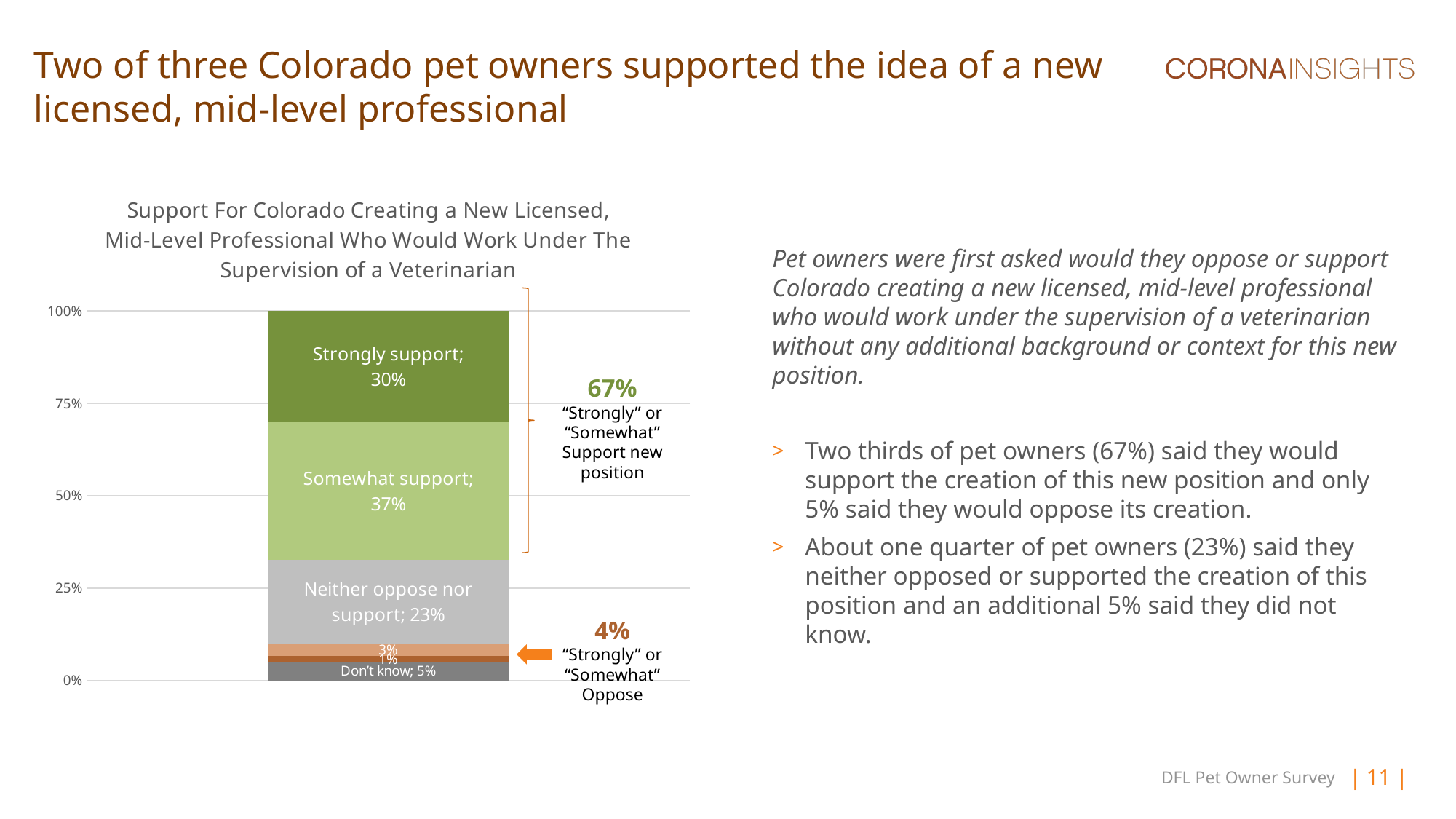
How many segments does the stacked bar contain? 6 What combined percentage of pet owners said they "Strongly" or "Somewhat" support the new position? 67% What percentage of pet owners answered "Don't know"? 5% What is the title of the chart? Support For Colorado Creating a New Licensed, Mid-Level Professional Who Would Work Under The Supervision of a Veterinarian What type of chart is shown on the slide? Stacked bar chart What percentage of pet owners said they somewhat support the new position? 37% Which is larger, the "Strongly support" share or the "Neither oppose nor support" share? Strongly support What percentage of pet owners said they neither oppose nor support the new position? 23% What percentage of pet owners said they strongly support the new position? 30% What combined percentage of pet owners said they "Strongly" or "Somewhat" oppose the new position? 4% What is the difference between the "Somewhat support" and "Strongly support" percentages? 7% Which response category makes up the largest segment of the bar? Somewhat support